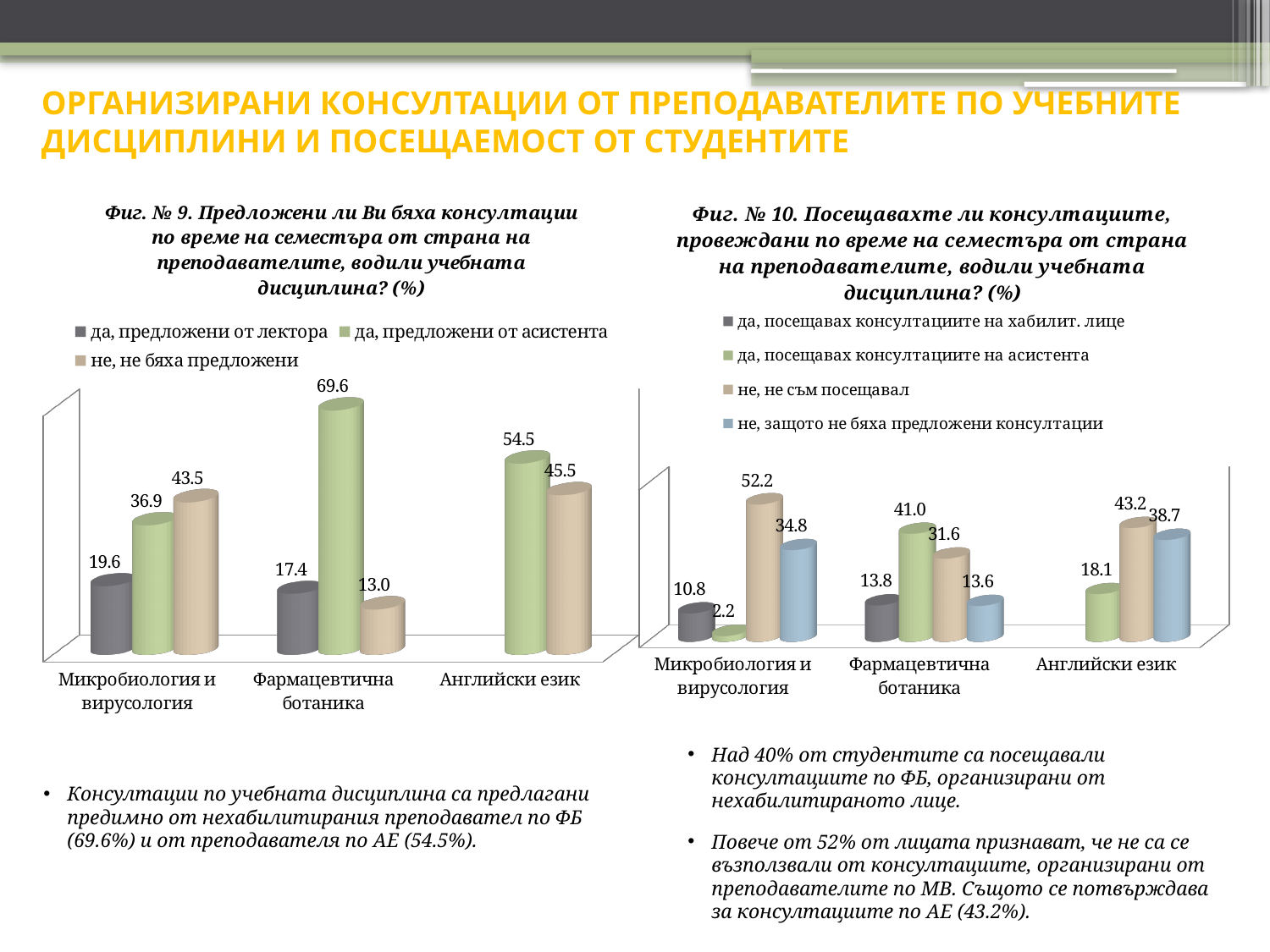
In Фиг. № 9 (left chart), what is the difference between 'да, предложени от асистента' and 'не, не бяха предложени' for Английски език? 9.0 In Фиг. № 9 (left chart), what is the value for 'не, не бяха предложени' for Микробиология и вирусология? 43.5 In Фиг. № 10 (right chart), which category has the lowest value for 'да, посещавах консултациите на асистента'? Микробиология и вирусология In Фиг. № 10 (right chart), what is the value for 'да, посещавах консултациите на асистента' for Фармацевтична ботаника? 41.0 In Фиг. № 10 (right chart), which is larger for Английски език: 'не, не съм посещавал' or 'не, защото не бяха предложени консултации'? не, не съм посещавал What type of chart is Фиг. № 9 (left chart)? Bar chart In Фиг. № 10 (right chart), what is the difference between 'не, не съм посещавал' and 'не, защото не бяха предложени консултации' for Микробиология и вирусология? 17.4 In Фиг. № 10 (right chart), how many series does the legend list? 4 In Фиг. № 9 (left chart), how many series does the legend list? 3 In Фиг. № 10 (right chart), what is the value for 'не, не съм посещавал' for Микробиология и вирусология? 52.2 In Фиг. № 9 (left chart), what is the value for 'да, предложени от асистента' for Фармацевтична ботаника? 69.6 In Фиг. № 9 (left chart), which category has the highest value for 'да, предложени от асистента'? Фармацевтична ботаника